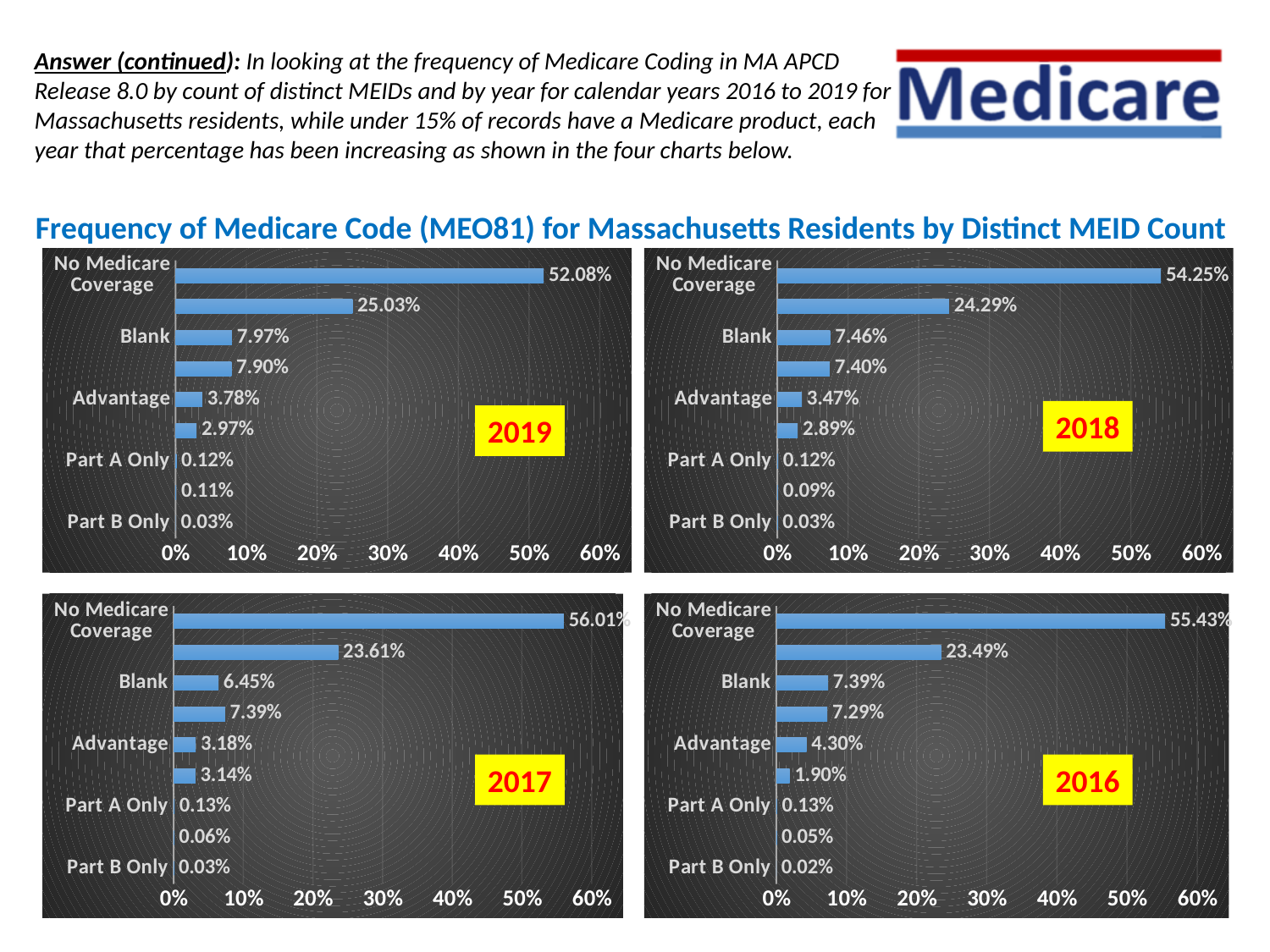
In the 2018 chart, what is the value for Advantage? 3.47% What type of chart is the 2018 chart? Bar chart What is the title shown above the four charts? Frequency of Medicare Code (MEO81) for Massachusetts Residents by Distinct MEID Count In the 2017 chart, is the value for No Medicare Coverage greater or less than 50%? greater In the 2016 chart, what is the value for Part B Only? 0.02% How many bars are plotted in the 2019 chart? 9 Which is larger: the Advantage value in the 2016 chart or the Advantage value in the 2017 chart? 2016 In the 2016 chart, which category has the highest value? No Medicare Coverage In the 2017 chart, what is the value for Blank? 6.45% In the 2018 chart, what is the difference between the No Medicare Coverage value and the Blank value? 46.79% In the 2019 chart, what is the value for No Medicare Coverage? 52.08% In the 2019 chart, which category has the lowest value? Part B Only